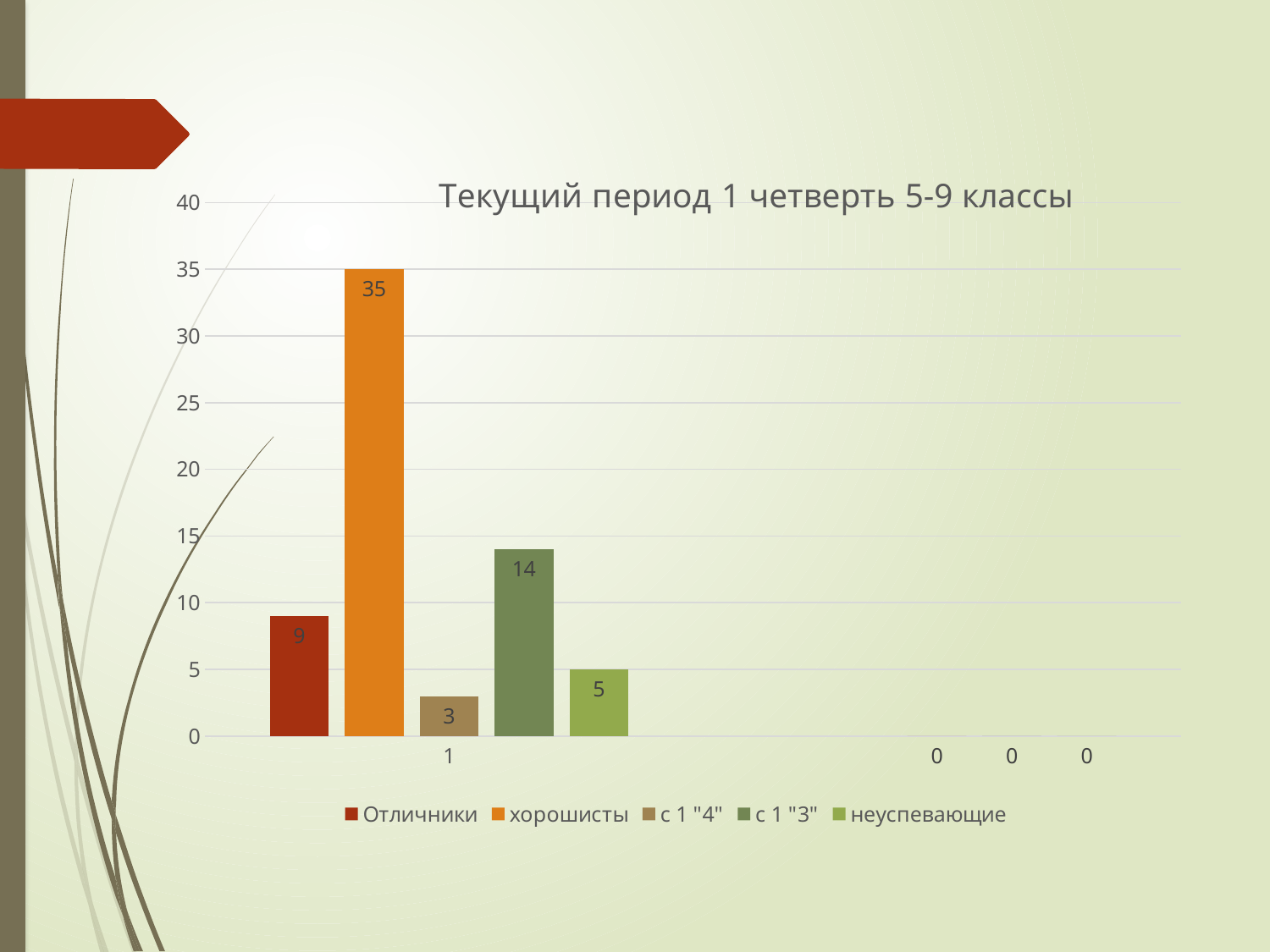
What is the value for неуспевающие? 5 What is the difference between the values for хорошисты and с 1 "3"? 21 Which is larger, the value for Отличники or the value for неуспевающие? Отличники What is the value for хорошисты? 35 What is the value for с 1 "4"? 3 What is the value for с 1 "3"? 14 What is the title of the chart? Текущий период 1 четверть 5-9 классы What type of chart is shown on the slide? bar chart What is the value for Отличники? 9 Which series has the highest value? хорошисты How many series does the legend list? 5